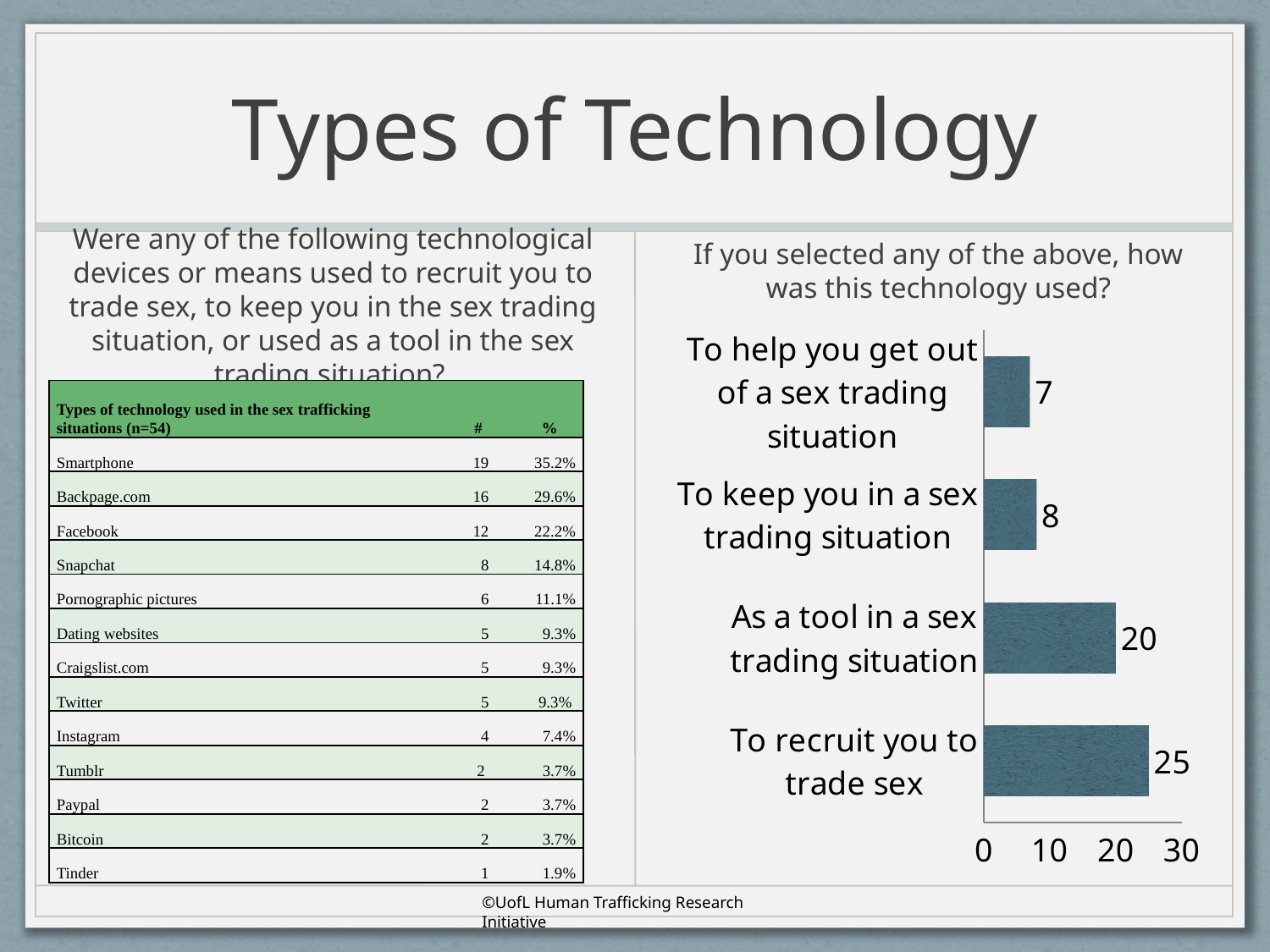
What is the value for "To keep you in a sex trading situation" in the bar chart? 8 Which category has the highest value in the bar chart? To recruit you to trade sex What kind of chart is shown on the right side of the slide? bar chart Which category has the lowest value in the bar chart? To help you get out of a sex trading situation Which is larger in the bar chart: the value for "To keep you in a sex trading situation" or the value for "To help you get out of a sex trading situation"? To keep you in a sex trading situation What is the value for "To recruit you to trade sex" in the bar chart? 25 Is the value for "As a tool in a sex trading situation" greater or less than 10 in the bar chart? greater How many categories does the bar chart show? 4 What is the value for "To help you get out of a sex trading situation" in the bar chart? 7 What is the difference between the values for "To recruit you to trade sex" and "As a tool in a sex trading situation" in the bar chart? 5 What is the value for "As a tool in a sex trading situation" in the bar chart? 20 What is the title above the bar chart on the right? If you selected any of the above, how was this technology used?